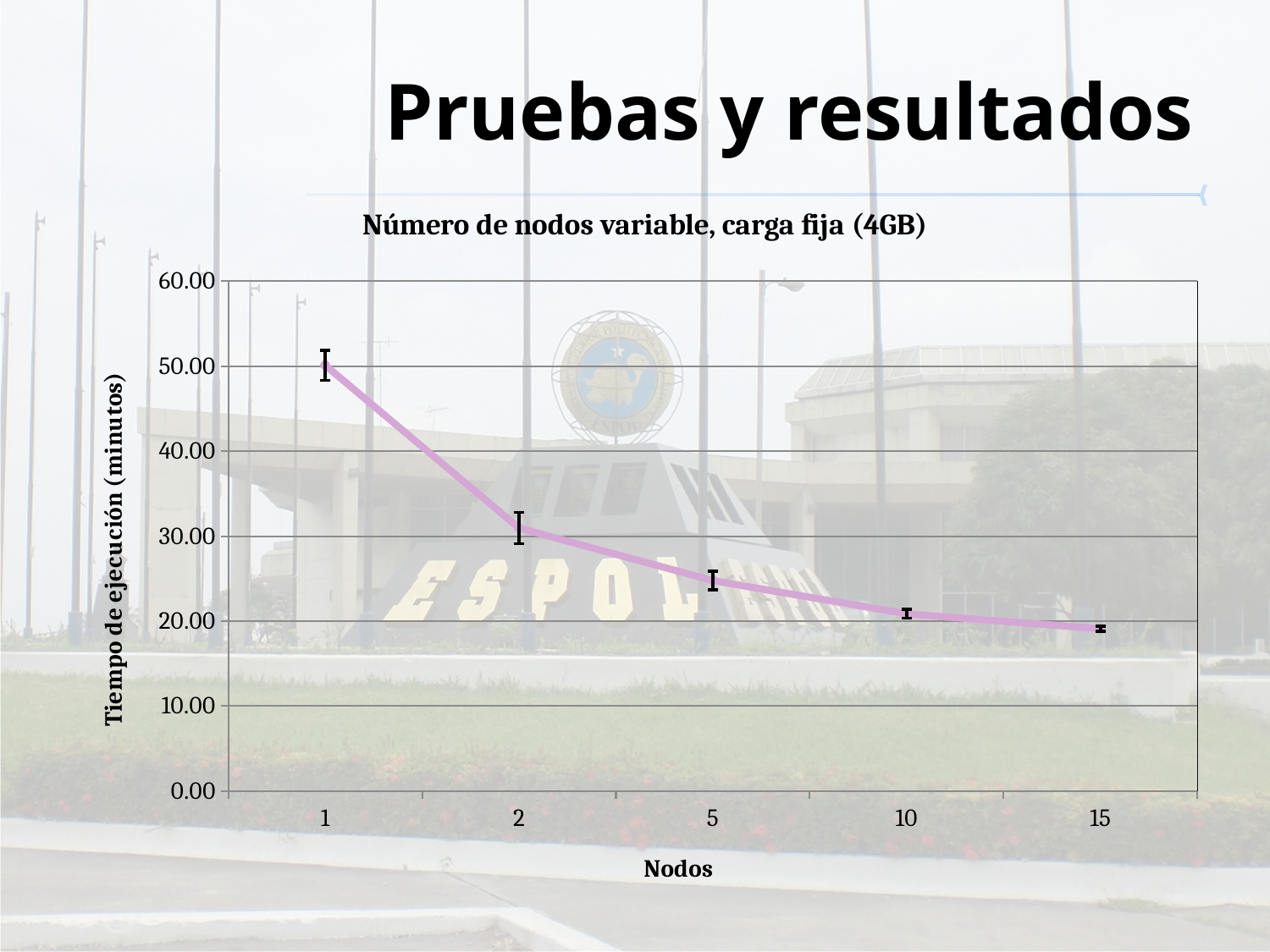
Which has a larger execution time, 2 nodes or 5 nodes? 2 nodes What is the label of the vertical axis? Tiempo de ejecución (minutos) Is the execution time for 15 nodes greater or less than 30? less Which number of nodes has the highest execution time? 1 How many data points are plotted on the line? 5 What kind of chart is shown on the slide? line chart Is the execution time for 2 nodes greater or less than 40? less Does the execution time rise or fall as the number of nodes increases? fall Is the execution time for 5 nodes greater or less than 30? less What is the title of the chart? Número de nodos variable, carga fija (4GB)